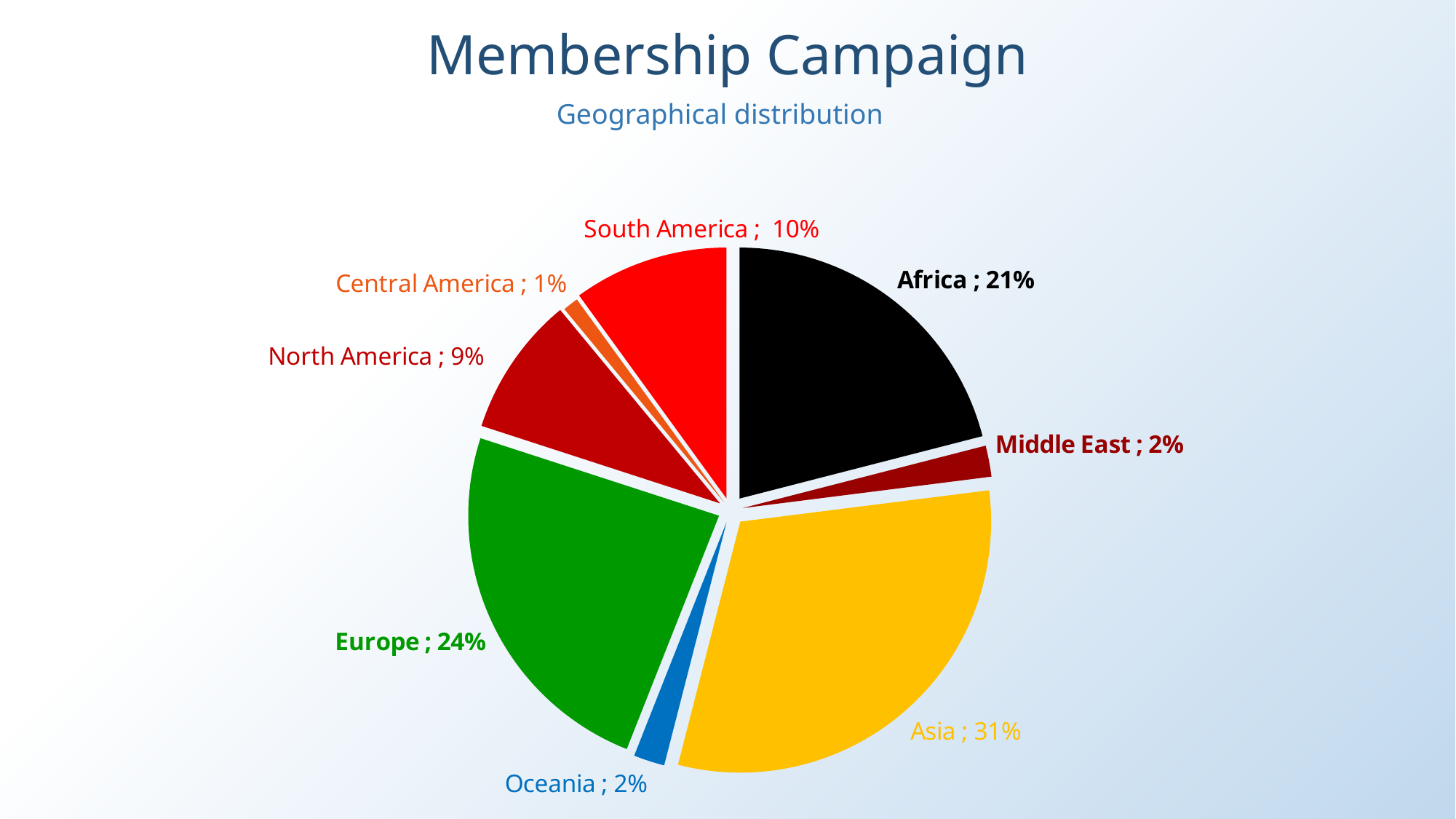
What share of the pie does Asia account for? 31% Which region has the largest slice of the pie? Asia Which region has the smallest slice of the pie? Central America What percentage is shown for Central America? 1% Which is larger, the share for Africa or the share for Europe? Europe What is the difference in percentage points between Asia and Africa? 10 What percentage is shown for Europe? 24% What is the title of the chart on the slide? Membership Campaign What is the difference in percentage points between Europe and South America? 14 What is the value labelled for North America? 9% What type of chart is shown on the slide? Pie chart How many regions are shown in the pie chart? 8